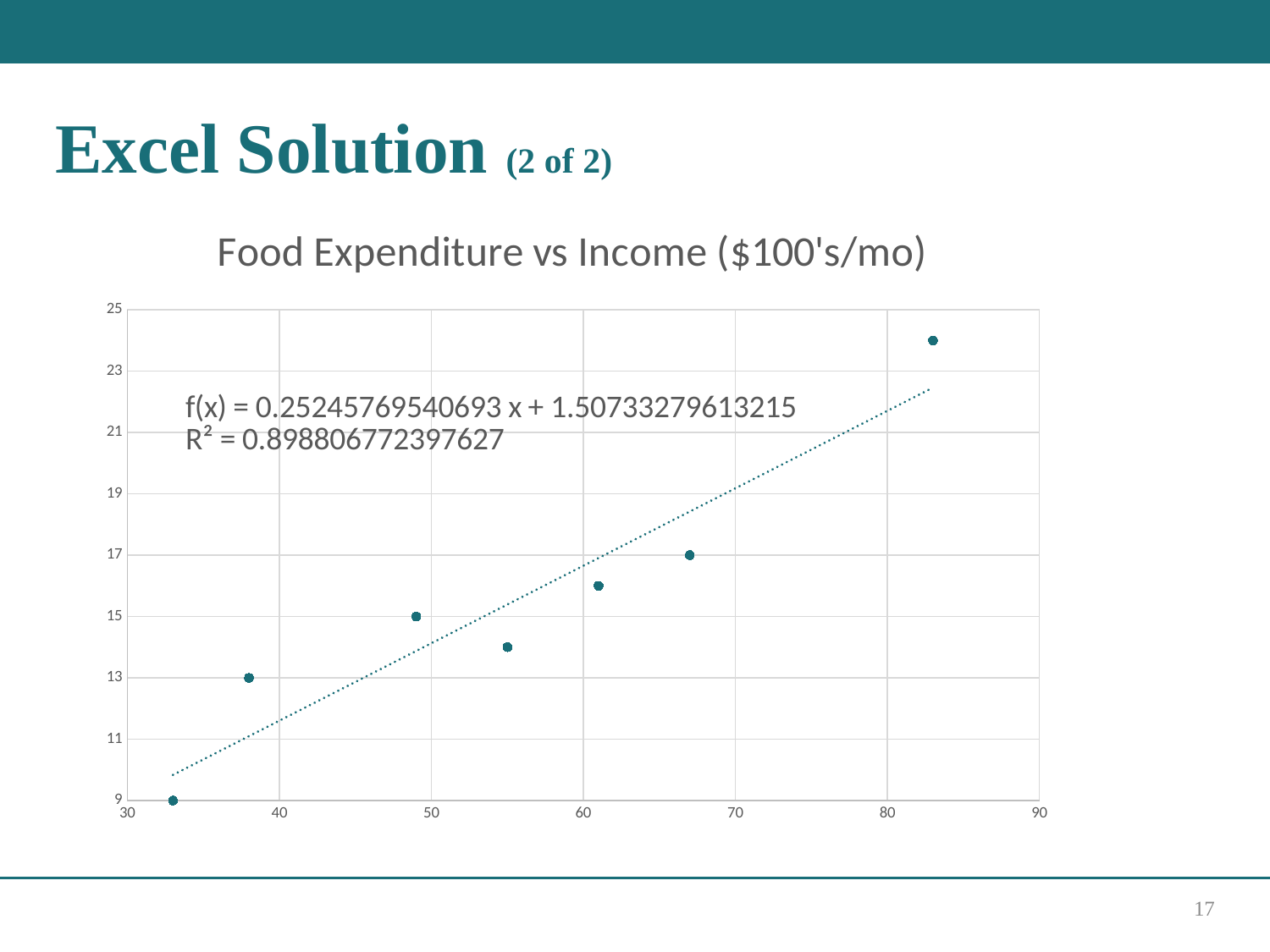
What is the y value of the second data point from the left? 13 Do the plotted values generally rise or fall as income increases along the x axis? Rise Is the y value of the rightmost (highest) data point greater or less than 23? greater How many data points are plotted on the chart? 7 Which data point has the highest y value, the leftmost point or the rightmost point? The rightmost point What is the intercept of the trendline equation shown on the chart? 1.50733279613215 What is the slope of the trendline equation shown on the chart? 0.25245769540693 What kind of chart is shown on the slide? Scatter plot What is the maximum value shown on the x axis? 90 What is the y value of the leftmost (lowest) data point? 9 What is the title of the chart? Food Expenditure vs Income ($100's/mo) What is the R² value shown on the chart? 0.898806772397627